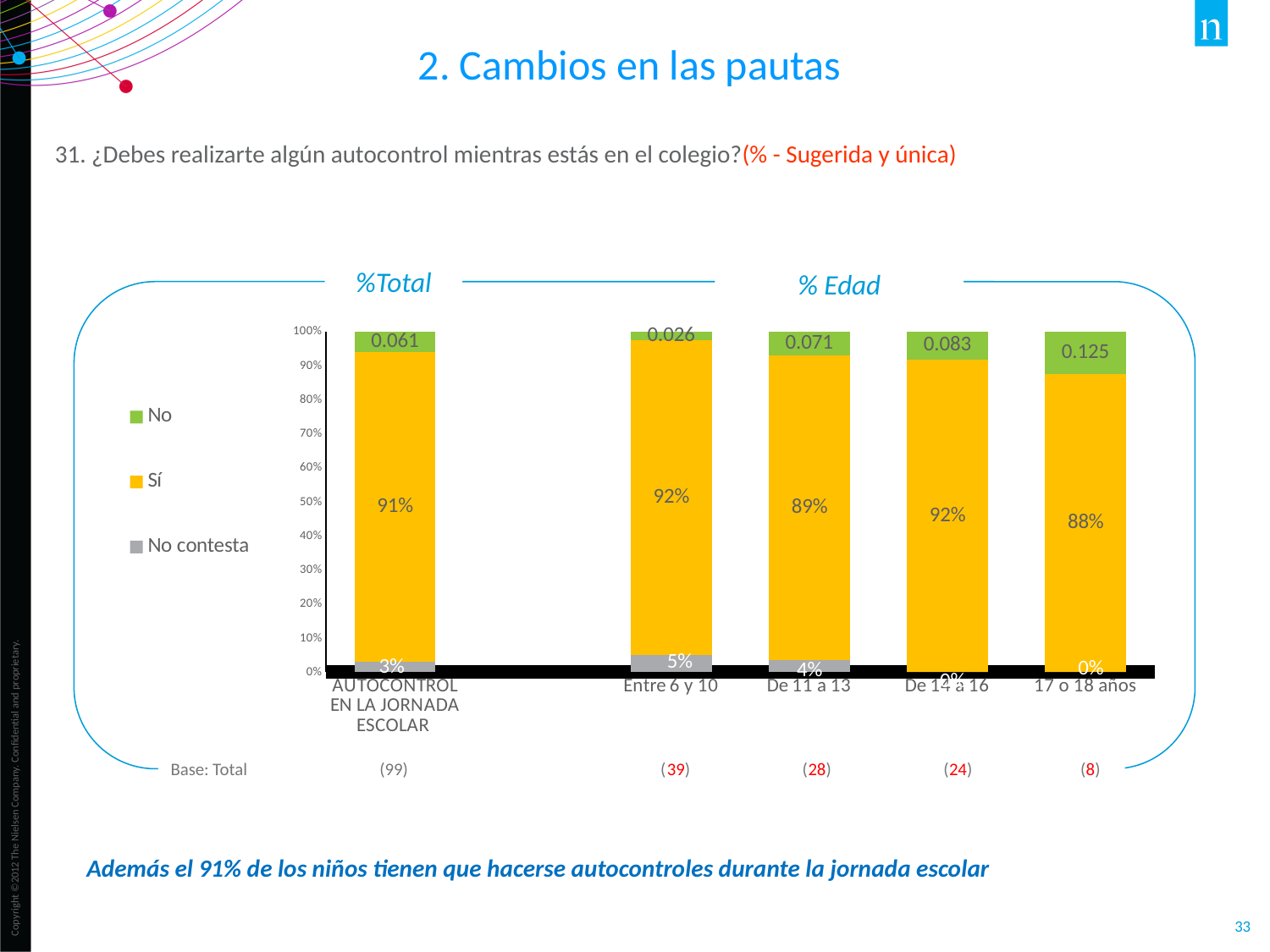
Which category has the lowest "Sí" value? 17 o 18 años What is the value of the "Sí" series for the "AUTOCONTROL EN LA JORNADA ESCOLAR" bar? 91% Is the "Sí" value larger for "De 11 a 13" or for "De 14 a 16"? De 14 a 16 What is the value of the "Sí" series for the "17 o 18 años" category? 88% What type of chart is shown on the slide? Stacked bar chart Which category has the highest "No contesta" value? Entre 6 y 10 What label is shown on the "No" segment of the "Entre 6 y 10" bar? 0.026 How many bars are plotted in the chart? 5 What is the difference between the "Sí" value for "Entre 6 y 10" and the "Sí" value for "17 o 18 años"? 4% What is the value of the "No contesta" series for the "Entre 6 y 10" category? 5% What label is shown on the "No" segment of the "17 o 18 años" bar? 0.125 How many series does the legend list? 3